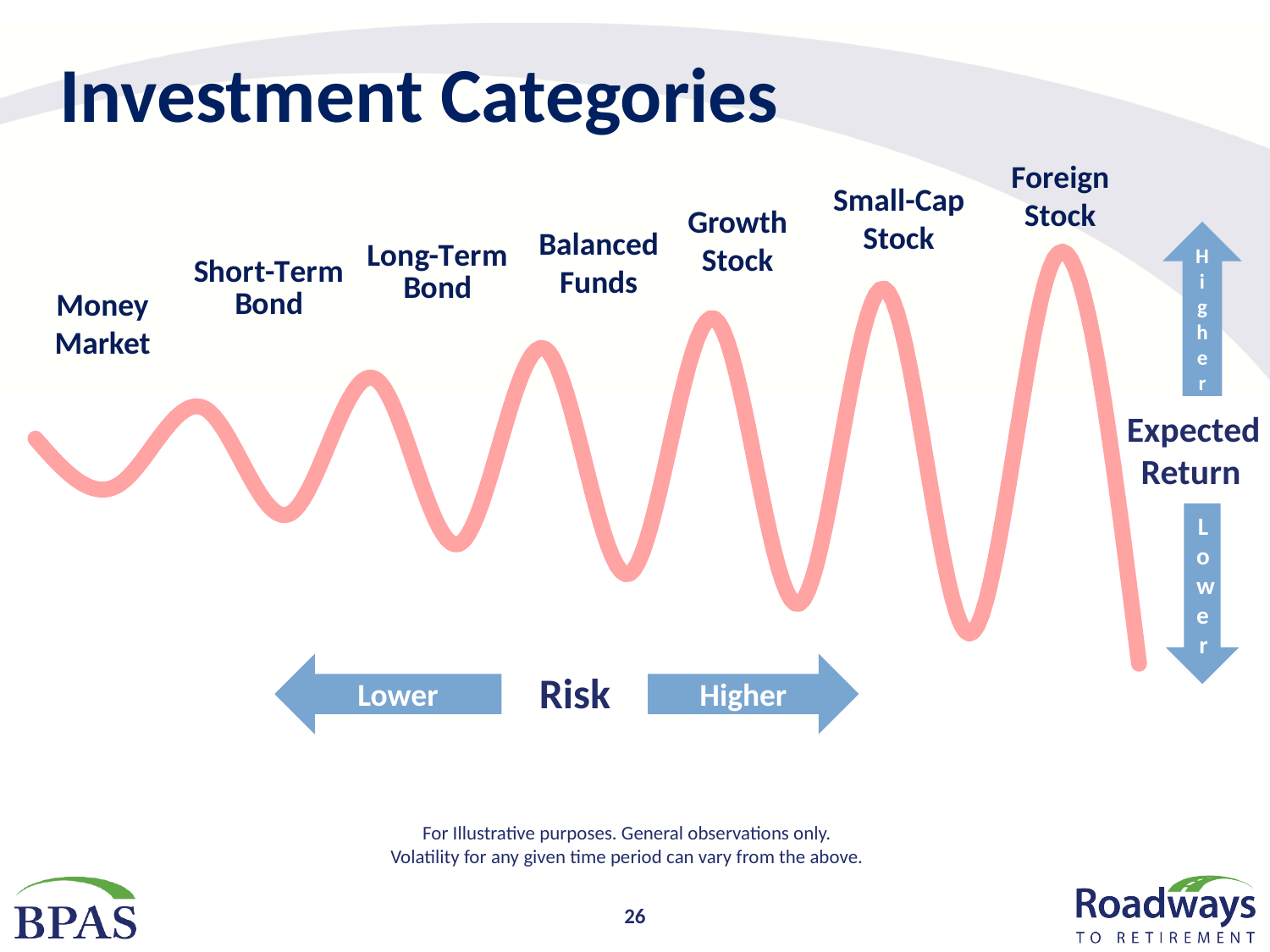
Do the swings of the line get larger or smaller moving from left to right? larger What does the horizontal arrow at the bottom of the chart represent? Risk What does the vertical arrow on the right side of the chart represent? Expected Return Which investment category's section of the line has the smallest up-and-down swing? Money Market Which has the larger swing on the line, Growth Stock or Short-Term Bond? Growth Stock Which investment category is labeled immediately to the right of Long-Term Bond? Balanced Funds How many investment categories are labeled along the wavy line? 7 Which investment category's section of the line reaches the highest peak? Foreign Stock What kind of chart is shown on the slide? line chart Which has the larger swing on the line, Balanced Funds or Small-Cap Stock? Small-Cap Stock Which investment category is placed at the far left of the line, at the lowest-risk end? Money Market Which investment category is placed at the far right of the line, at the highest-risk end? Foreign Stock